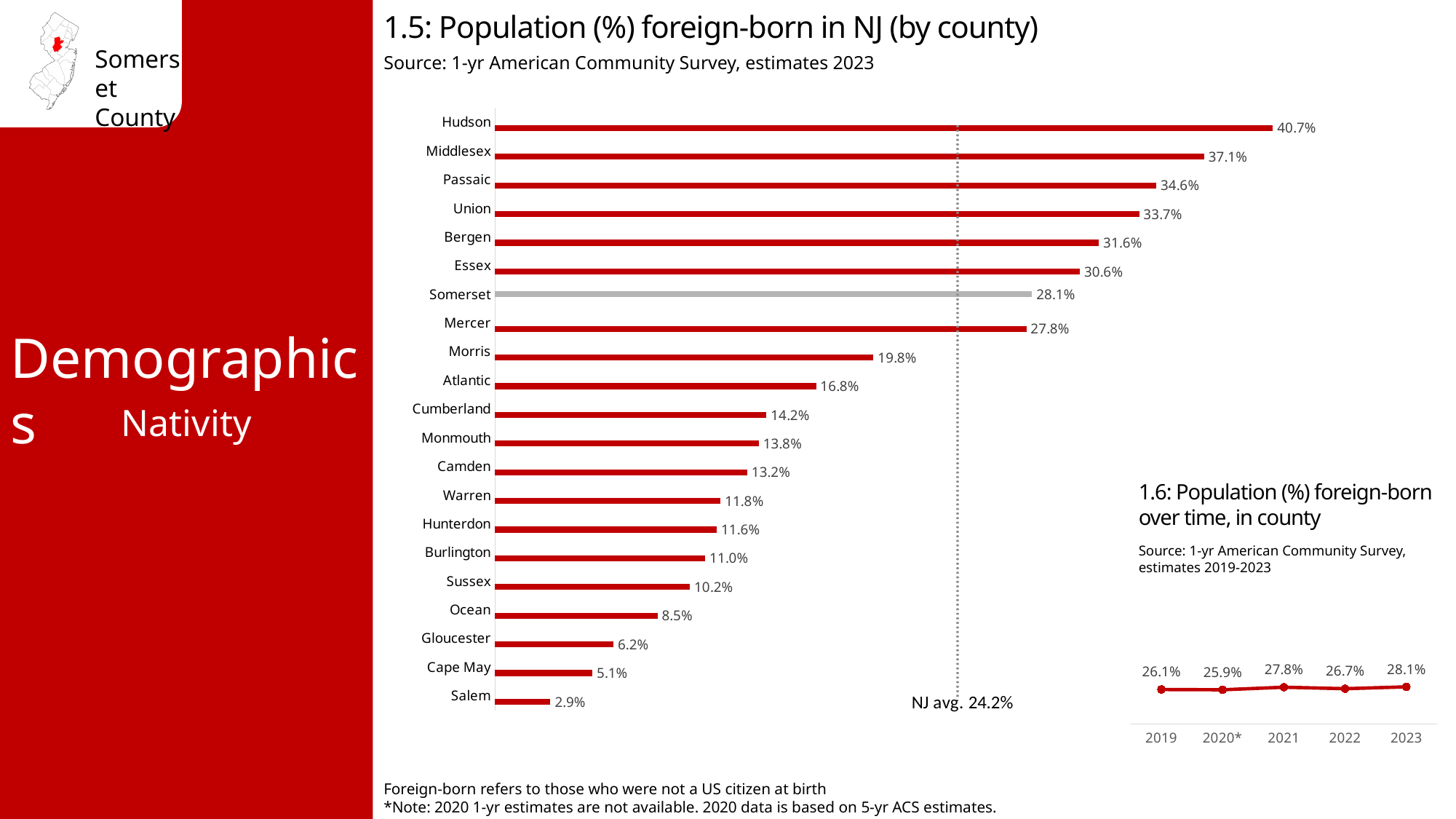
In chart 1.5 (Population (%) foreign-born in NJ by county), which county has the highest value? Hudson In chart 1.5 (Population (%) foreign-born in NJ by county), which is larger, Morris or Atlantic? Morris In chart 1.6 (Population (%) foreign-born over time, in county), what is the difference between 2023 and 2019? 2.0% In chart 1.6 (Population (%) foreign-born over time, in county), which year has the highest value? 2023 In chart 1.6 (Population (%) foreign-born over time, in county), what is the value for 2021? 27.8% In chart 1.5 (Population (%) foreign-born in NJ by county), what NJ average is marked by the dotted line? 24.2% In chart 1.5 (Population (%) foreign-born in NJ by county), what is the value for Somerset? 28.1% In chart 1.5 (Population (%) foreign-born in NJ by county), what is the difference between Hudson and Middlesex? 3.6% What kind of chart is chart 1.6 (Population (%) foreign-born over time, in county)? Line chart In chart 1.5 (Population (%) foreign-born in NJ by county), how many counties are plotted? 21 What kind of chart is chart 1.5 (Population (%) foreign-born in NJ by county)? Bar chart In chart 1.5 (Population (%) foreign-born in NJ by county), which county has the lowest value? Salem